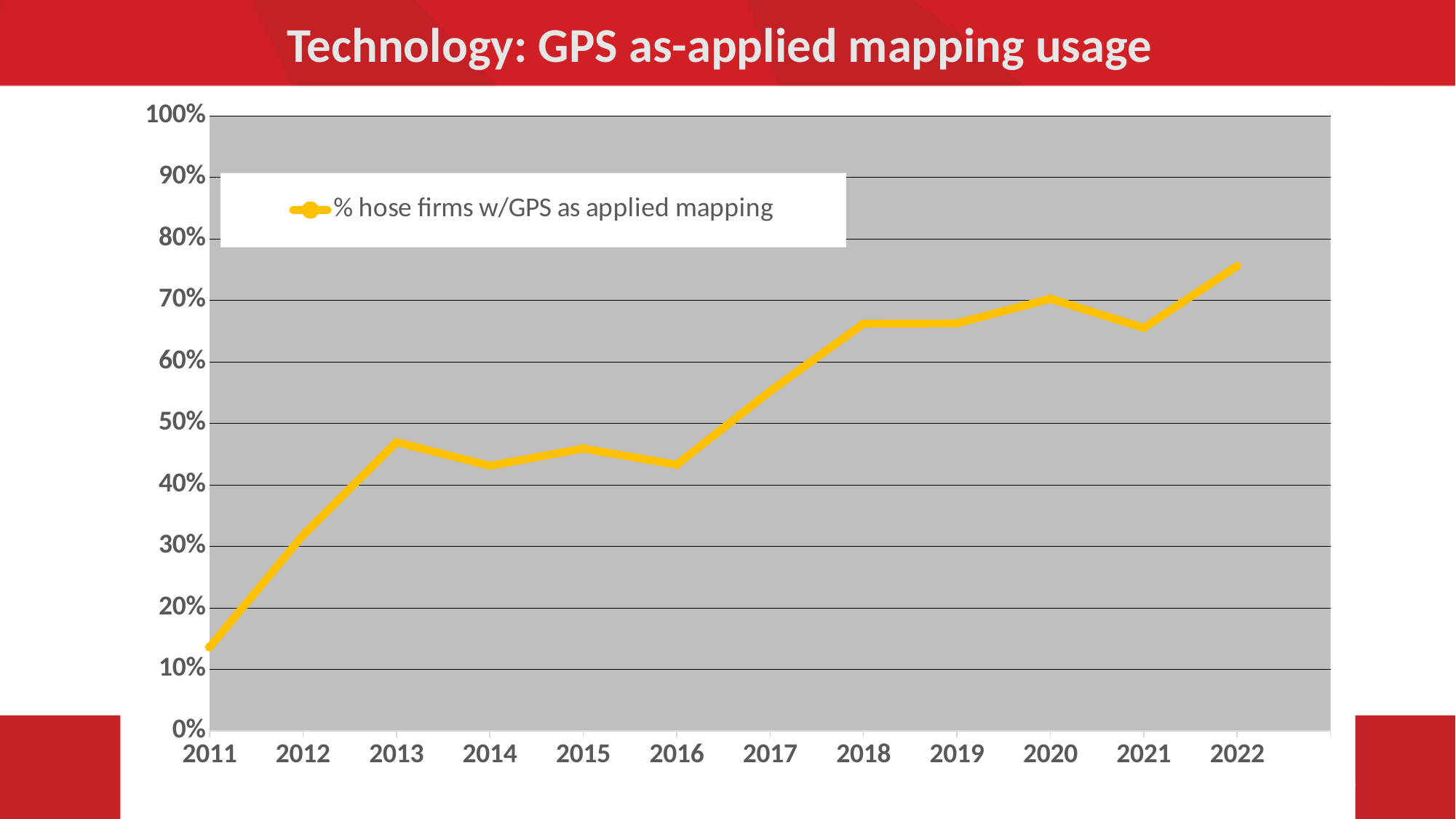
Is the value for 2016 greater or less than 50%? less Which year has the highest value for % hose firms w/GPS as applied mapping? 2022 Which is larger, the value for 2018 or the value for 2016? 2018 How many series does the legend list? 1 Is the value for 2013 greater or less than 40%? greater Is the value for 2011 greater or less than 20%? less How many years are plotted along the x axis? 12 Overall, do the values rise or fall from 2011 to 2022? rise Which year has the lowest value for % hose firms w/GPS as applied mapping? 2011 What is the series name shown in the legend? % hose firms w/GPS as applied mapping What kind of chart is shown on the slide? line chart